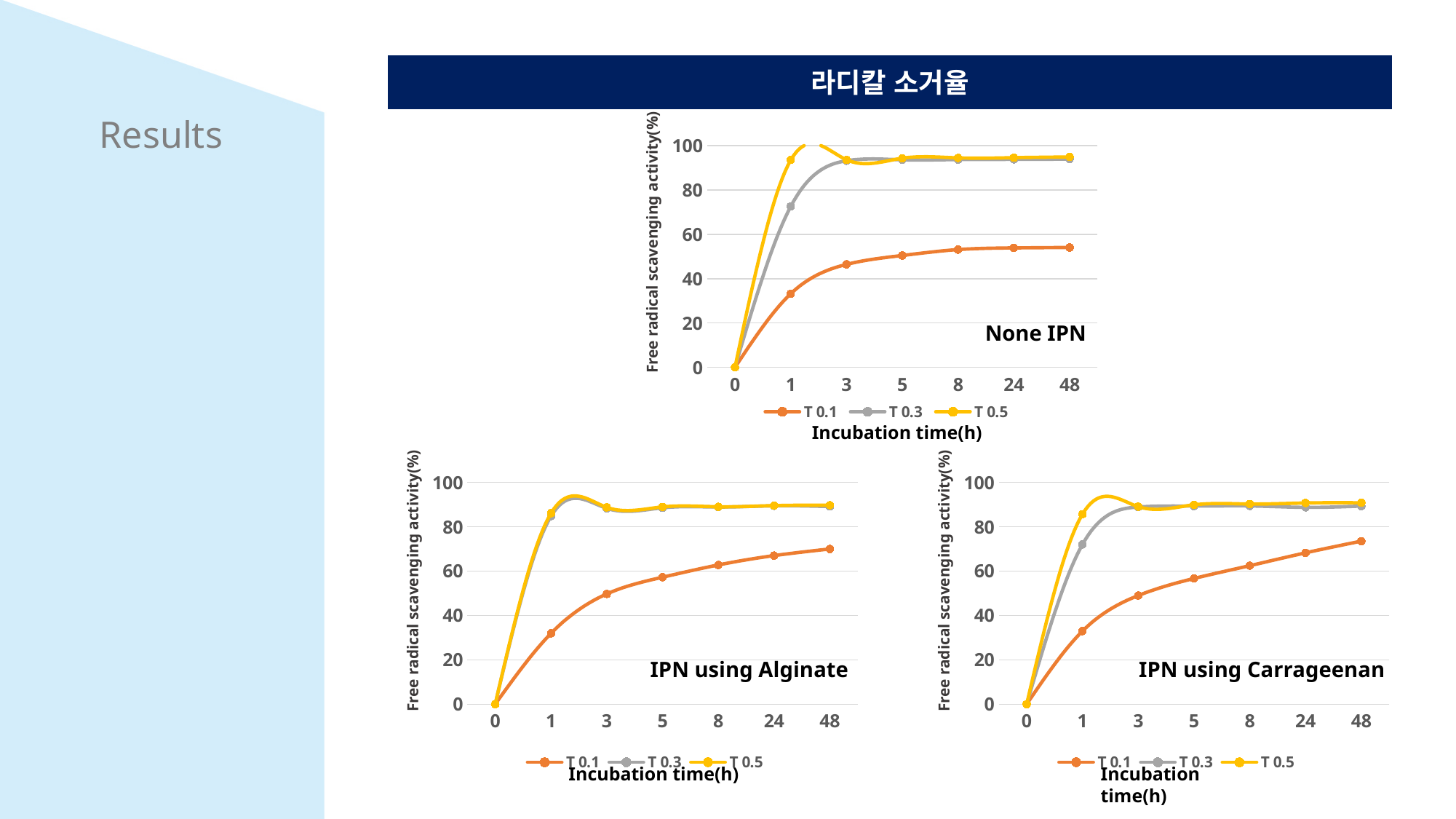
How many incubation time points are plotted on the x axis of the "IPN using Carrageenan" chart? 7 In the "IPN using Alginate" chart, which is larger at 1 h, T 0.1 or T 0.5? T 0.5 How many series does the legend of the "IPN using Alginate" chart list? 3 What is the value for T 0.1 at 0 h in the "IPN using Carrageenan" chart? 0 In the "IPN using Carrageenan" chart, is the value for T 0.3 at 1 h greater or less than 60? greater In the "IPN using Carrageenan" chart, does the T 0.1 series rise or fall as incubation time increases? rise What kind of chart is the "None IPN" chart? line chart In the "IPN using Alginate" chart, is the value for T 0.1 at 48 h greater or less than 60? greater What is the x-axis title of the "None IPN" chart? Incubation time(h) In the "None IPN" chart, is the value for T 0.5 at 1 h greater or less than 80? greater In the "None IPN" chart, which series has the lowest value at 48 h? T 0.1